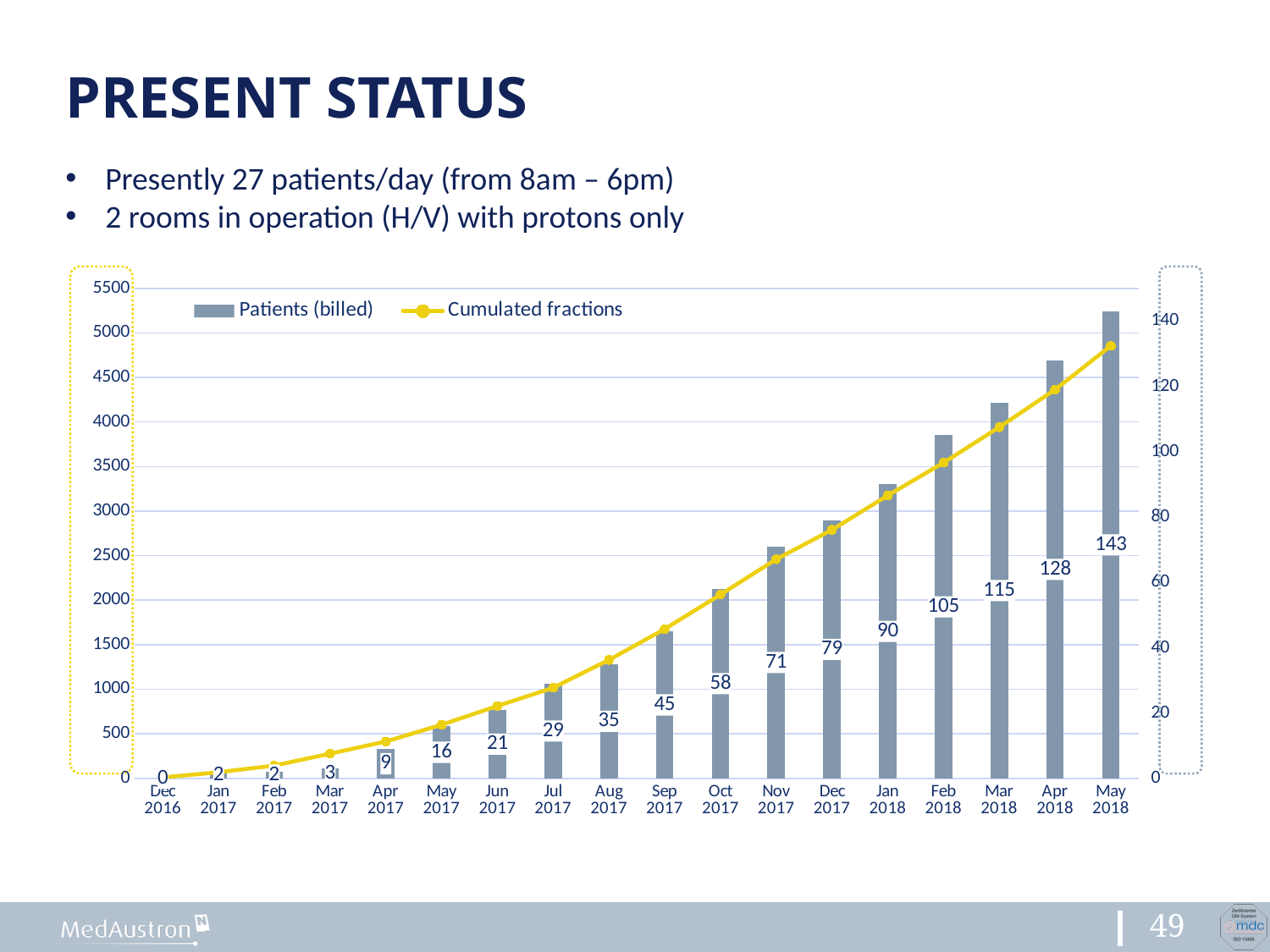
What is the Patients (billed) value for Sep 2017? 45 What is the Patients (billed) value for Jan 2018? 90 Is the Cumulated fractions value for May 2018 greater or less than 4500? greater Which month has the highest number of patients (billed)? May 2018 Which month has more patients (billed), Jun 2017 or Aug 2017? Aug 2017 What is the difference in patients (billed) between May 2018 and Apr 2018? 15 How many patients (billed) are shown for May 2018? 143 How many series does the chart legend list? 2 Which month has the lowest number of patients (billed)? Dec 2016 What is the difference in patients (billed) between Nov 2017 and Oct 2017? 13 Is the Cumulated fractions value for Dec 2017 greater or less than 2500? greater How many months are shown on the x axis of the chart? 18